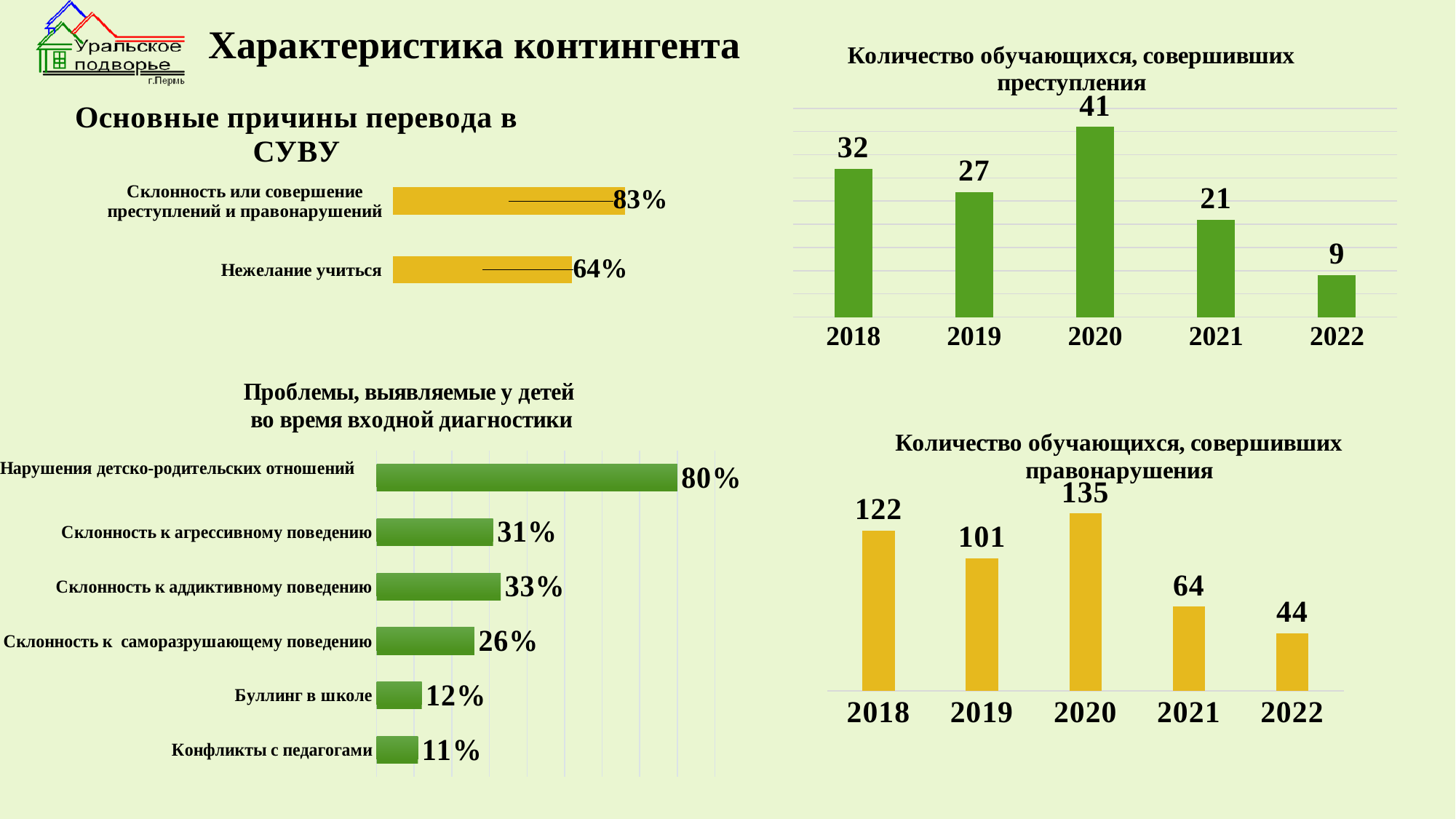
In the chart 'Количество обучающихся, совершивших правонарушения', do the values rise or fall from 2020 to 2022? fall In the chart 'Количество обучающихся, совершивших правонарушения', which year has the highest value? 2020 In the chart 'Основные причины перевода в СУВУ', what is the value for 'Нежелание учиться'? 64% In the chart 'Количество обучающихся, совершивших правонарушения', what is the value for 2021? 64 In the chart 'Проблемы, выявляемые у детей во время входной диагностики', how many categories are shown? 6 What kind of chart is 'Основные причины перевода в СУВУ'? bar chart In the chart 'Количество обучающихся, совершивших преступления', which year has the lowest value? 2022 In the chart 'Количество обучающихся, совершивших преступления', what is the difference between the values for 2018 and 2019? 5 In the chart 'Количество обучающихся, совершивших правонарушения', how many years are shown on the x axis? 5 In the chart 'Количество обучающихся, совершивших преступления', what is the value for 2020? 41 In the chart 'Проблемы, выявляемые у детей во время входной диагностики', which category has the highest value? Нарушения детско-родительских отношений In the chart 'Проблемы, выявляемые у детей во время входной диагностики', what is the value for 'Склонность к аддиктивному поведению'? 33%